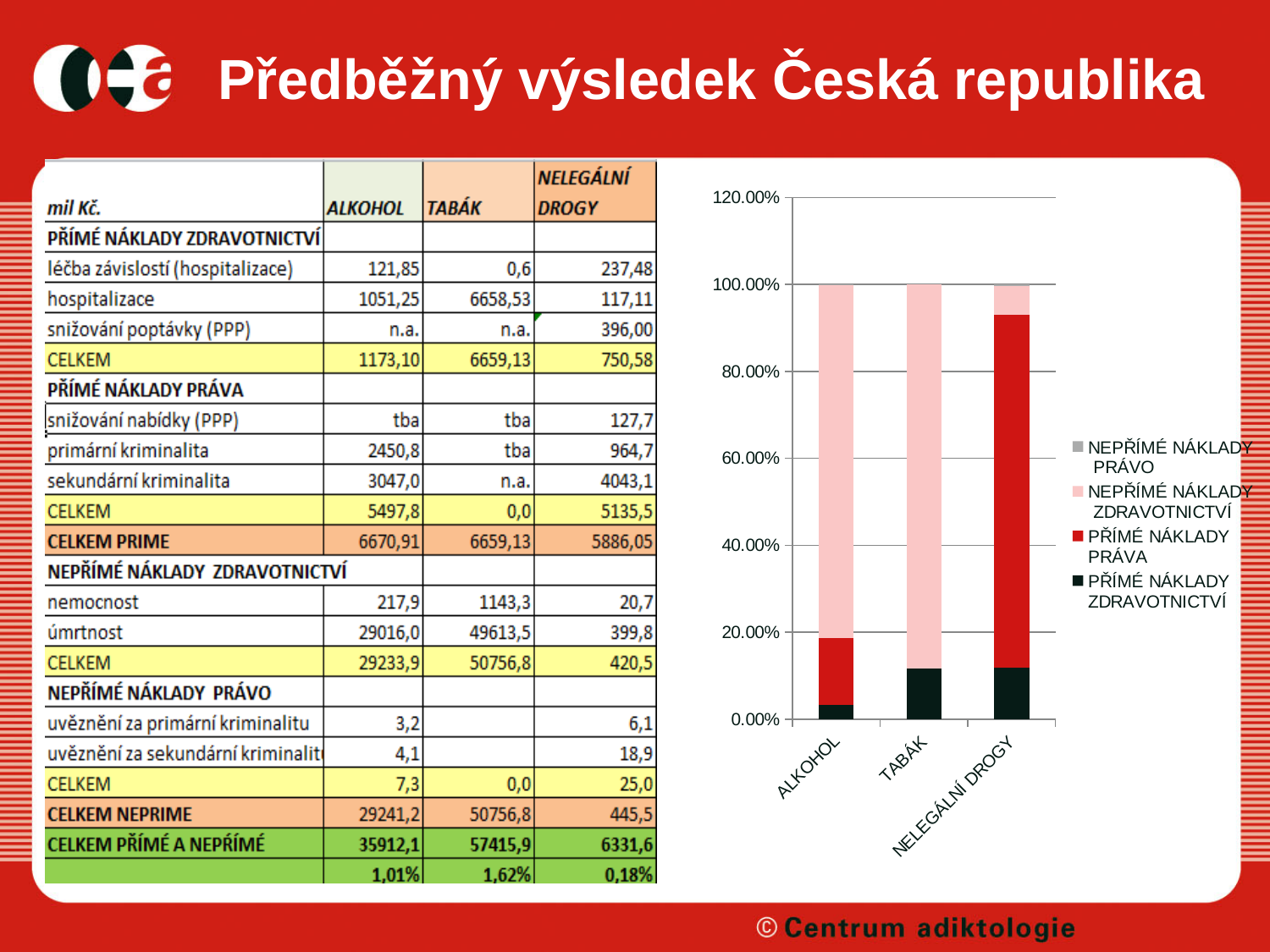
What kind of chart is shown on the right of the slide? stacked bar chart Is the PŘÍMÉ NÁKLADY PRÁVA share for NELEGÁLNÍ DROGY in the chart greater or less than 60%? greater How many series does the chart's legend list? 4 Which category has the largest PŘÍMÉ NÁKLADY PRÁVA share in the chart? NELEGÁLNÍ DROGY Which category has the smallest PŘÍMÉ NÁKLADY ZDRAVOTNICTVÍ share in the chart? ALKOHOL How many categories are shown on the x axis of the chart? 3 In the chart, is the PŘÍMÉ NÁKLADY PRÁVA share larger for ALKOHOL or for NELEGÁLNÍ DROGY? NELEGÁLNÍ DROGY Which category has the largest NEPŘÍMÉ NÁKLADY ZDRAVOTNICTVÍ share in the chart? TABÁK Is the NEPŘÍMÉ NÁKLADY ZDRAVOTNICTVÍ share for NELEGÁLNÍ DROGY in the chart greater or less than 20%? less What is the highest value shown on the chart's y axis? 120.00% Which category is shown first on the x axis of the chart? ALKOHOL In the chart, is the PŘÍMÉ NÁKLADY ZDRAVOTNICTVÍ share larger for ALKOHOL or for TABÁK? TABÁK